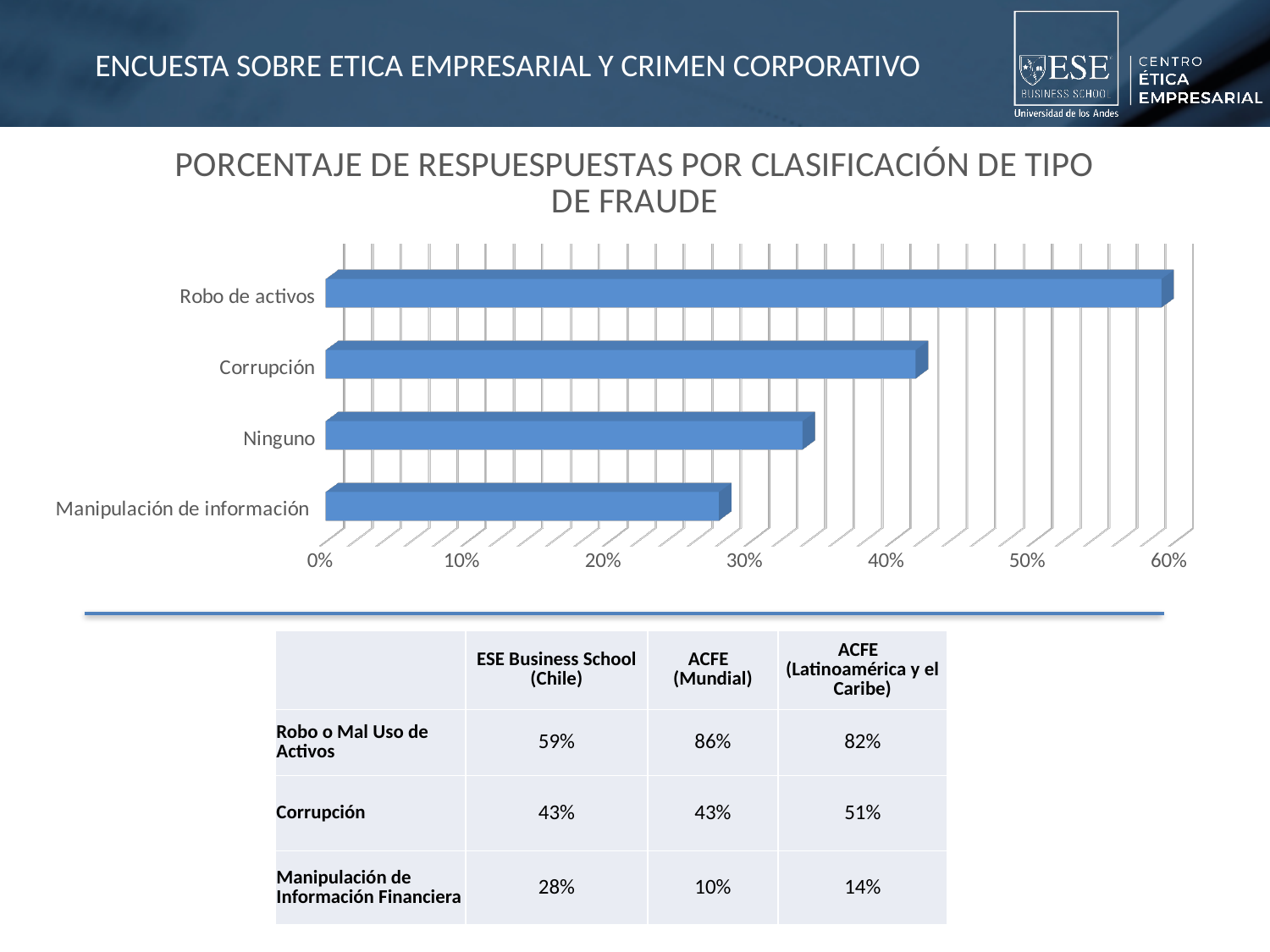
Which is larger, the value for Corrupción or the value for Ninguno? Corrupción What kind of chart is shown on the slide? bar chart How many categories are plotted in the chart? 4 Is the value for Manipulación de información greater or less than 30%? less Is the value for Corrupción greater or less than 40%? greater Is the value for Ninguno greater or less than 30%? greater Which category has the lowest value in the chart? Manipulación de información What is the title of the chart? PORCENTAJE DE RESPUESPUESTAS POR CLASIFICACIÓN DE TIPO DE FRAUDE What is the highest value shown on the chart's horizontal axis? 60% Which category has the highest value in the chart? Robo de activos Which is larger, the value for Ninguno or the value for Manipulación de información? Ninguno